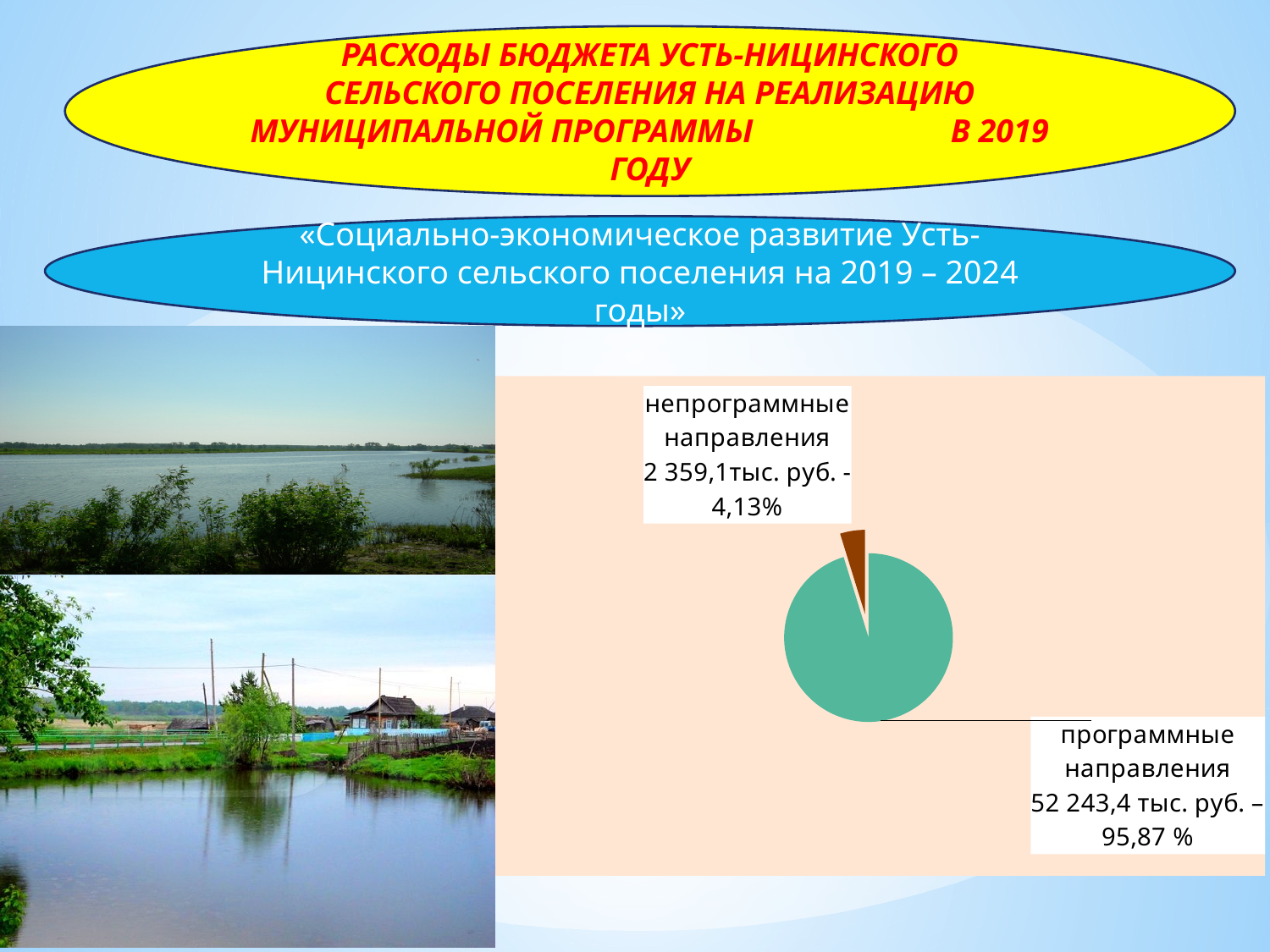
What is the difference in тыс. руб. between «программные направления» and «непрограммные направления»? 49 884,3 тыс. руб. What is the value for «непрограммные направления» in the pie chart? 2 359,1 тыс. руб. What share of the pie does «непрограммные направления» represent? 4,13% What share of the pie does «программные направления» represent? 95,87 % Which slice of the pie chart is the smallest? непрограммные направления How many slices does the pie chart have? 2 Which is larger: «программные направления» or «непрограммные направления»? программные направления Which slice of the pie chart is the largest? программные направления What kind of chart is shown on the slide? pie chart What is the value for «программные направления» in the pie chart? 52 243,4 тыс. руб. What colour is the slice for «непрограммные направления» in the pie chart? brown What is the total of the two slices in the pie chart, in тыс. руб.? 54 602,5 тыс. руб.